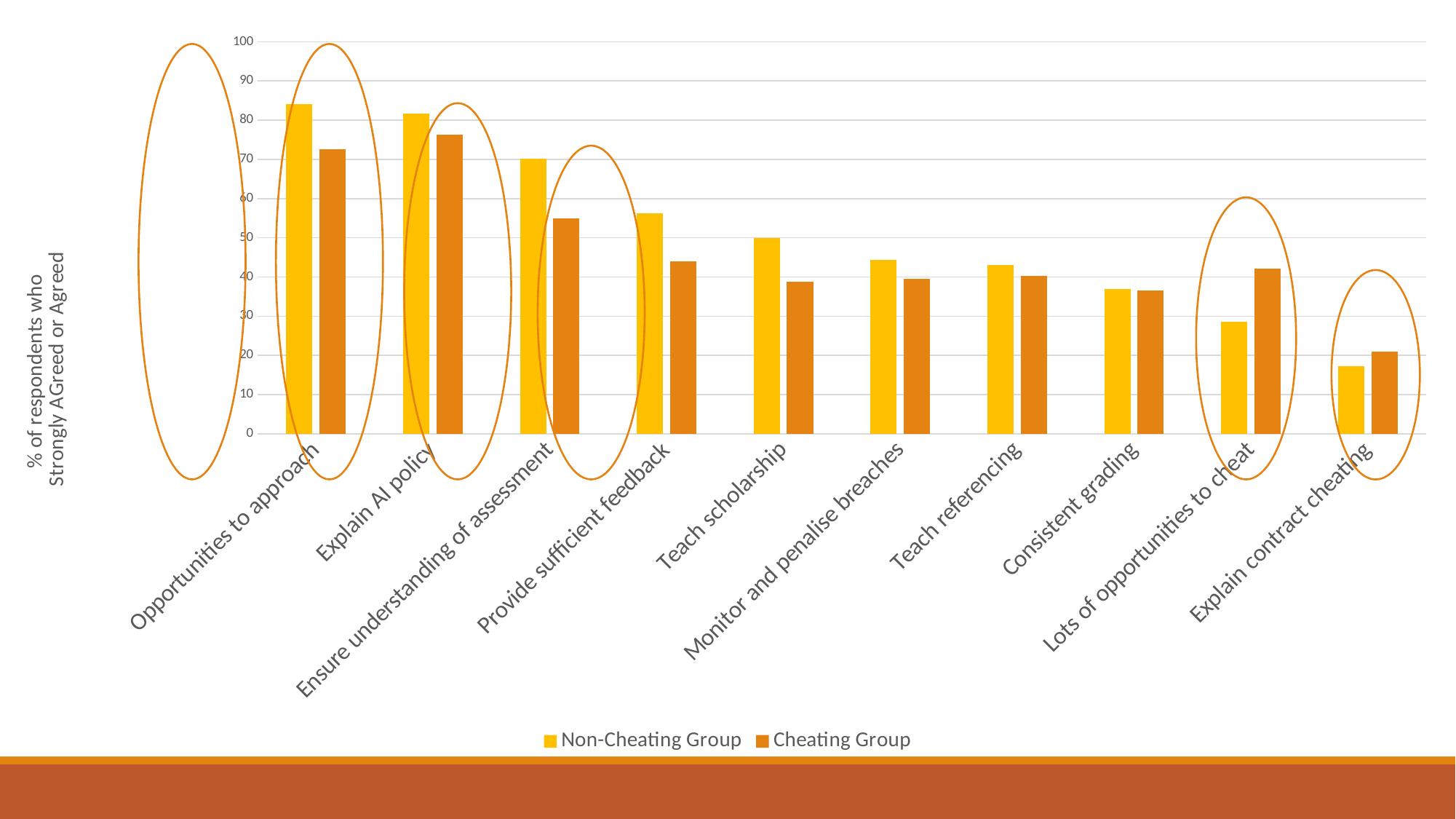
What kind of chart is shown on the slide? Bar chart Is the Non-Cheating Group value for Lots of opportunities to cheat greater or less than 40? less How many categories are shown on the x axis? 10 Which category has the lowest value for the Non-Cheating Group? Explain contract cheating Which category has the highest value for the Non-Cheating Group? Opportunities to approach Is the Non-Cheating Group value for Opportunities to approach greater or less than 80? greater Do the Non-Cheating Group values rise or fall from left to right along the x axis? Fall For Lots of opportunities to cheat, which group has the larger value? Cheating Group Which category has the highest value for the Cheating Group? Explain AI policy What is the label on the vertical axis? % of respondents who Strongly AGreed or Agreed Is the Cheating Group value for Explain AI policy greater or less than 70? greater How many series does the legend list? 2